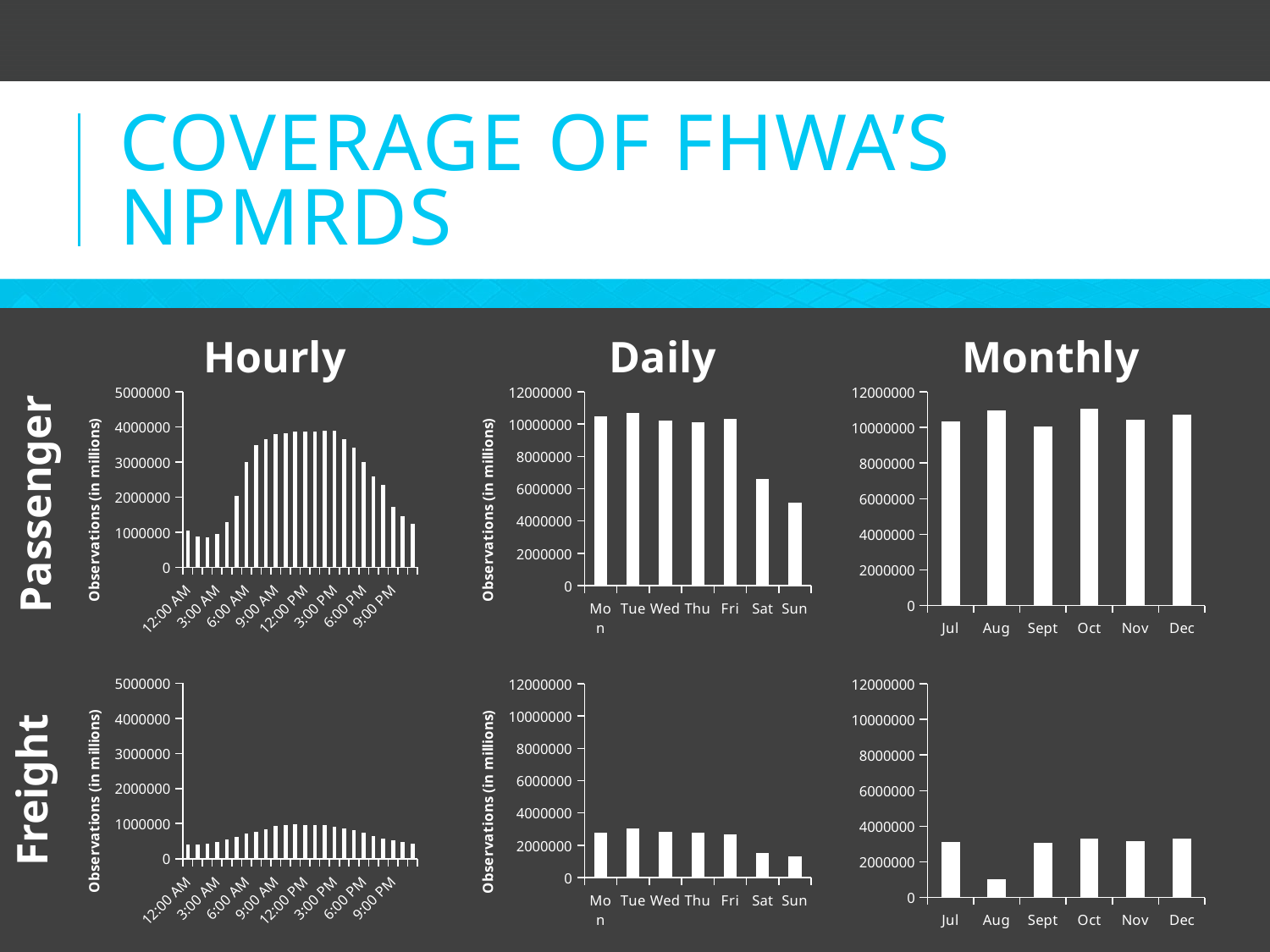
In the Freight Monthly chart, is the value for Aug greater or less than 2000000? less In the Passenger Daily chart, which is larger, the value for Sat or the value for Sun? Sat In the Freight Daily chart, which day has the lowest value? Sun In the Passenger Daily chart, which day has the lowest value? Sun In the Freight Daily chart, is the value for Sat greater or less than 2000000? less What kind of chart is the Passenger Daily chart? bar chart In the Passenger Monthly chart, is the value for Sept greater or less than 8000000? greater In the Freight Monthly chart, which month has the lowest value? Aug How many months are shown on the x axis of the Passenger Monthly chart? 6 How many days are shown on the x axis of the Freight Daily chart? 7 What is the y-axis title of the Passenger Hourly chart? Observations (in millions)